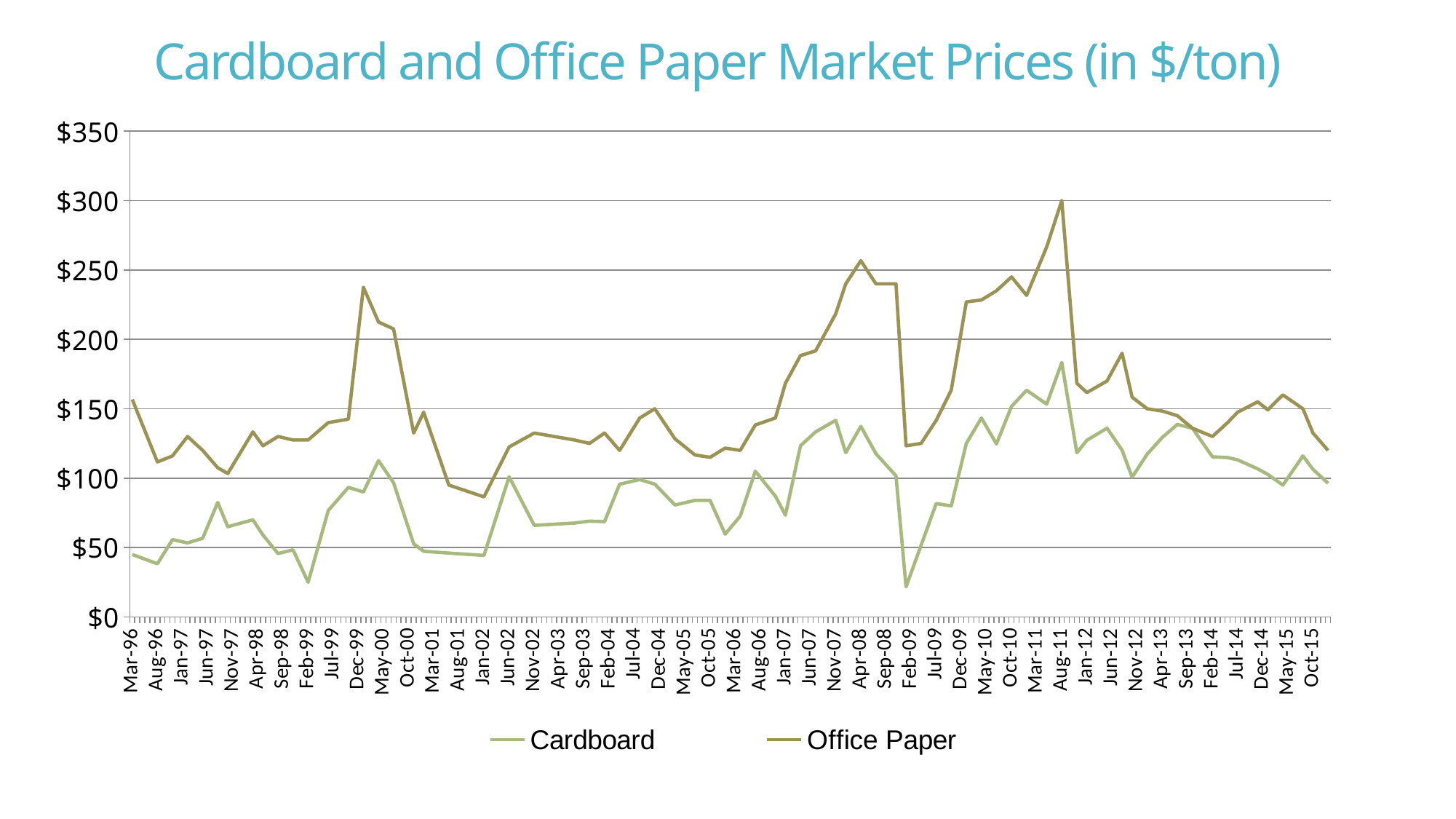
At Dec-99, which series has the larger value, Cardboard or Office Paper? Office Paper Is the value for Office Paper at Dec-99 greater or less than $200? greater Is the value for Office Paper at Jan-02 greater or less than $100? less What kind of chart is shown on the slide? line chart What is the title of the chart? Cardboard and Office Paper Market Prices (in $/ton) Which series reaches the highest value on the chart? Office Paper At which x-axis label does the Office Paper line reach its peak? Aug-11 At which x-axis label does the Cardboard line reach its lowest value? Feb-09 How many series does the legend list? 2 Which series is plotted in the darker olive line? Office Paper Is the value for Cardboard at Feb-09 greater or less than $50? less Does the Office Paper line rise or fall overall from Aug-11 to Oct-15? fall